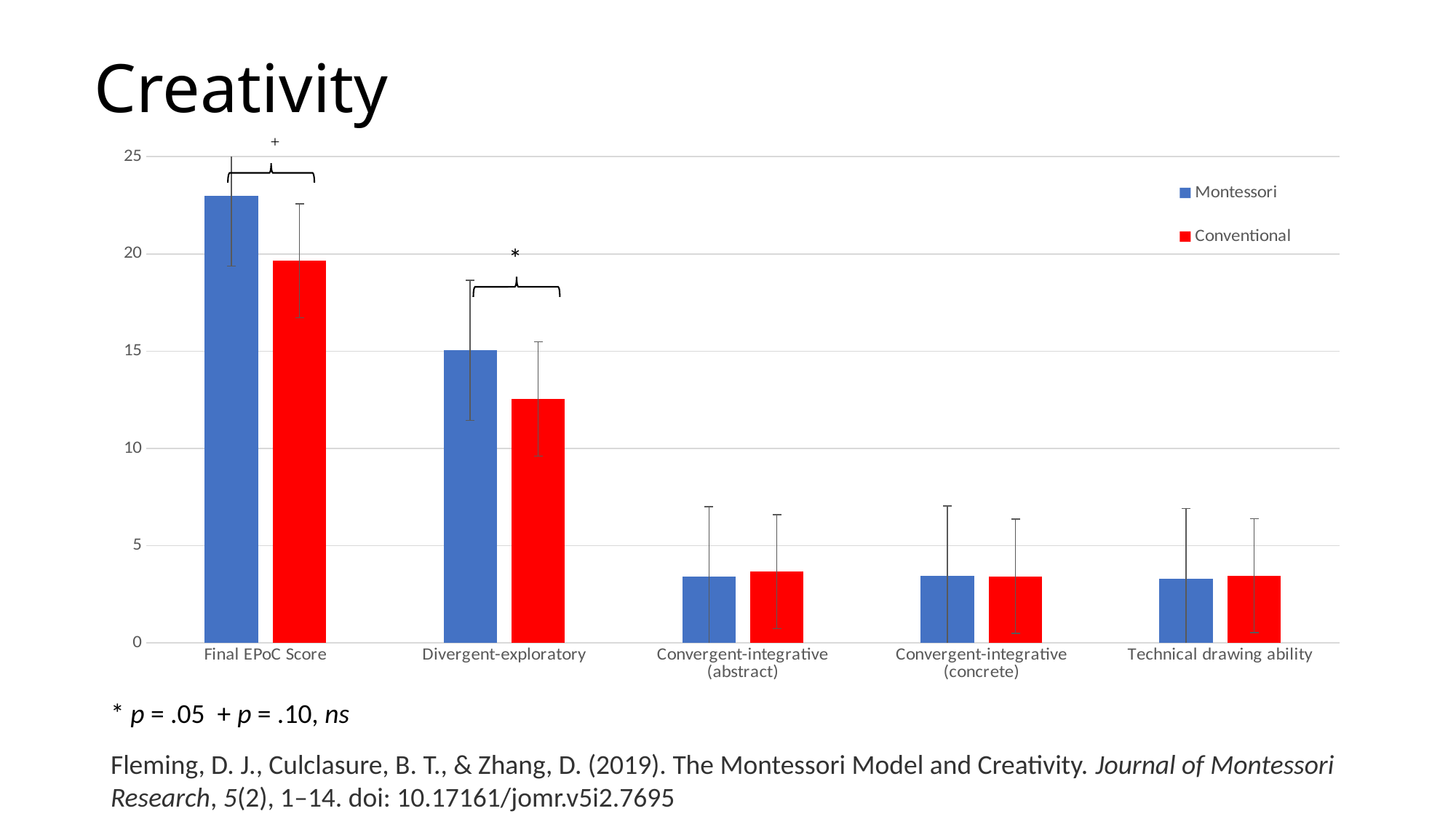
What colour are the Conventional bars? red Is the Conventional value for Final EPoC Score greater or less than 20? less Is the Conventional value for Divergent-exploratory greater or less than 15? less For Divergent-exploratory, which series has the larger value, Montessori or Conventional? Montessori What kind of chart is shown on the slide? bar chart Is the Montessori value for Final EPoC Score greater or less than 20? greater How many categories are shown on the x axis? 5 Which category has the highest Montessori value? Final EPoC Score How many series does the legend list? 2 Which category has the highest Conventional value? Final EPoC Score